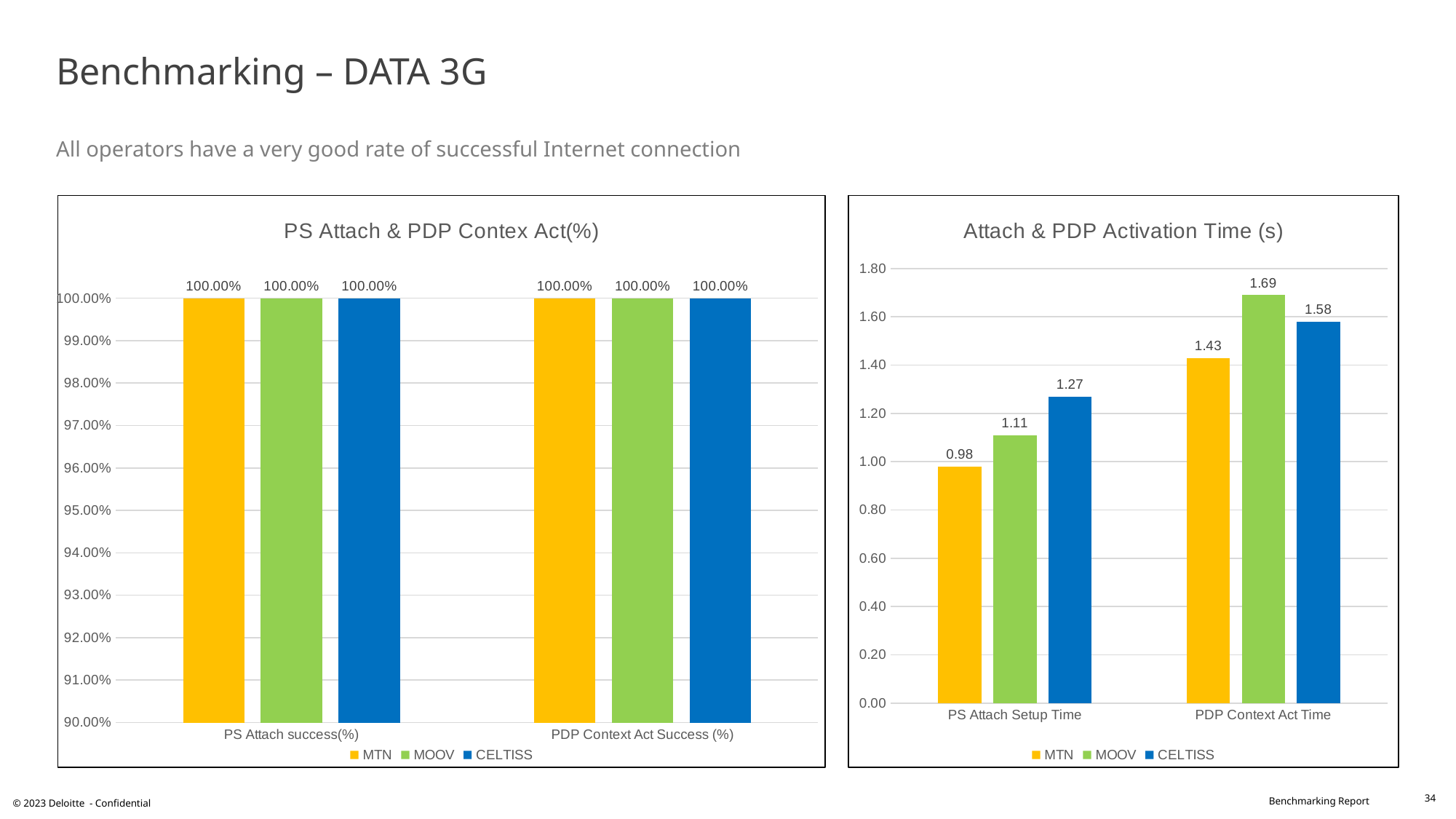
What kind of chart is the 'Attach & PDP Activation Time (s)' chart? bar chart In the 'Attach & PDP Activation Time (s)' chart, what is the value for CELTISS for PS Attach Setup Time? 1.27 How many series does the legend of the 'PS Attach & PDP Contex Act(%)' chart list? 3 In the 'Attach & PDP Activation Time (s)' chart, what is the difference between CELTISS and MTN for PDP Context Act Time? 0.15 In the 'Attach & PDP Activation Time (s)' chart, what is the value for MTN for PS Attach Setup Time? 0.98 In the 'Attach & PDP Activation Time (s)' chart, is the value for MTN for PDP Context Act Time greater or less than 1.40? greater In the 'Attach & PDP Activation Time (s)' chart, which operator has the highest PDP Context Act Time? MOOV In the 'Attach & PDP Activation Time (s)' chart, which operator has the lowest PS Attach Setup Time? MTN How many categories are shown on the x axis of the 'Attach & PDP Activation Time (s)' chart? 2 In the 'Attach & PDP Activation Time (s)' chart, which is larger for PS Attach Setup Time: MOOV or CELTISS? CELTISS In the 'Attach & PDP Activation Time (s)' chart, what is the value for MOOV for PDP Context Act Time? 1.69 In the 'PS Attach & PDP Contex Act(%)' chart, what is the value for MOOV for PS Attach success(%)? 100.00%